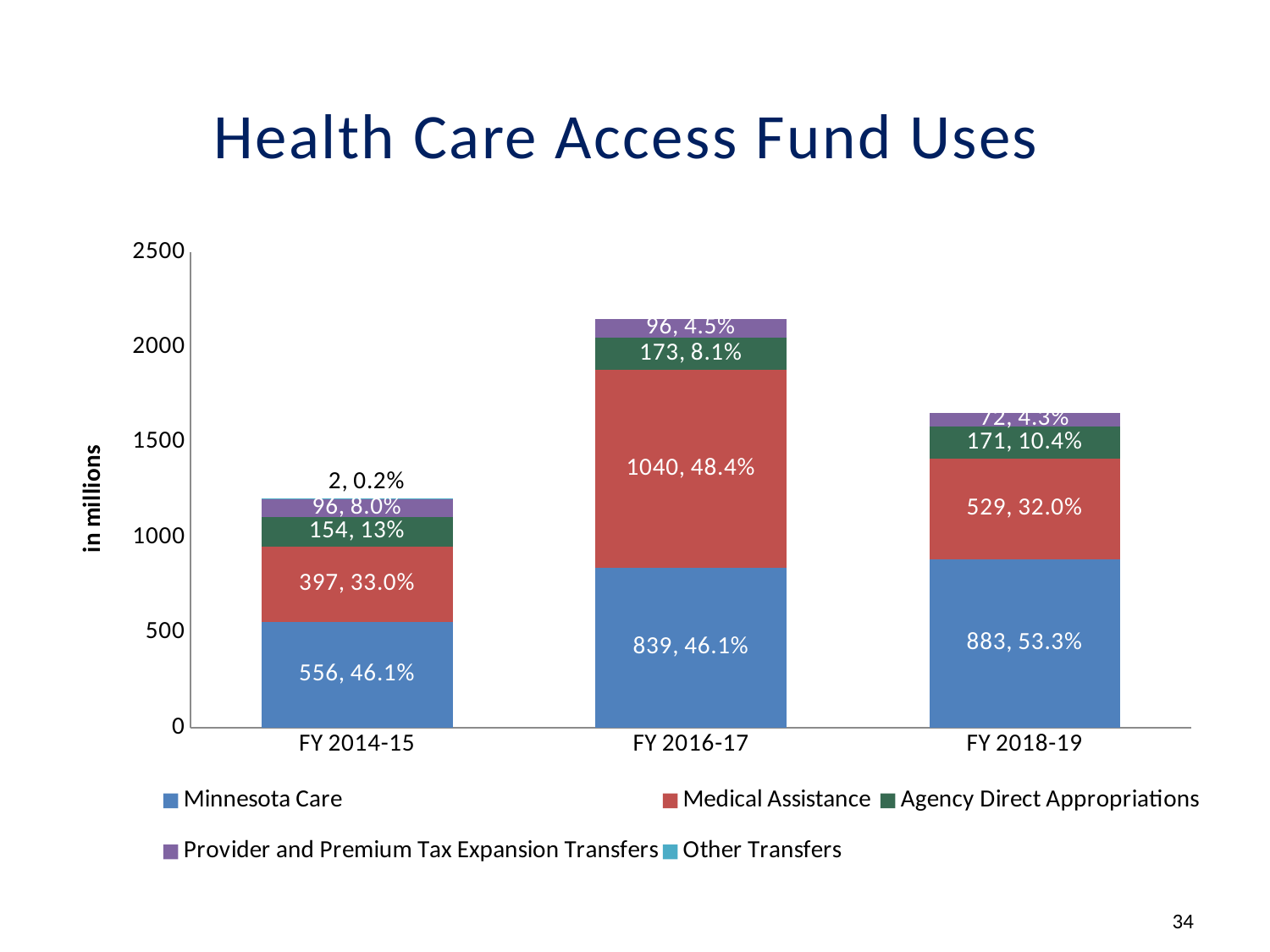
In which fiscal year is the Medical Assistance value highest? FY 2016-17 What is the total of the FY 2014-15 stacked bar? 1205 What percentage share is shown for Agency Direct Appropriations in FY 2018-19? 10.4% What is the difference between the Medical Assistance values for FY 2016-17 and FY 2018-19? 511 How many fiscal years are shown on the x axis? 3 What is the value for Minnesota Care in FY 2014-15? 556 In which fiscal year is the Minnesota Care value lowest? FY 2014-15 What is the value for Provider and Premium Tax Expansion Transfers in FY 2018-19? 72 How many series does the legend list? 5 Which is larger in FY 2016-17: Minnesota Care or Medical Assistance? Medical Assistance What is the value for Medical Assistance in FY 2016-17? 1040 Is the total height of the FY 2016-17 stacked bar greater or less than 2000? greater